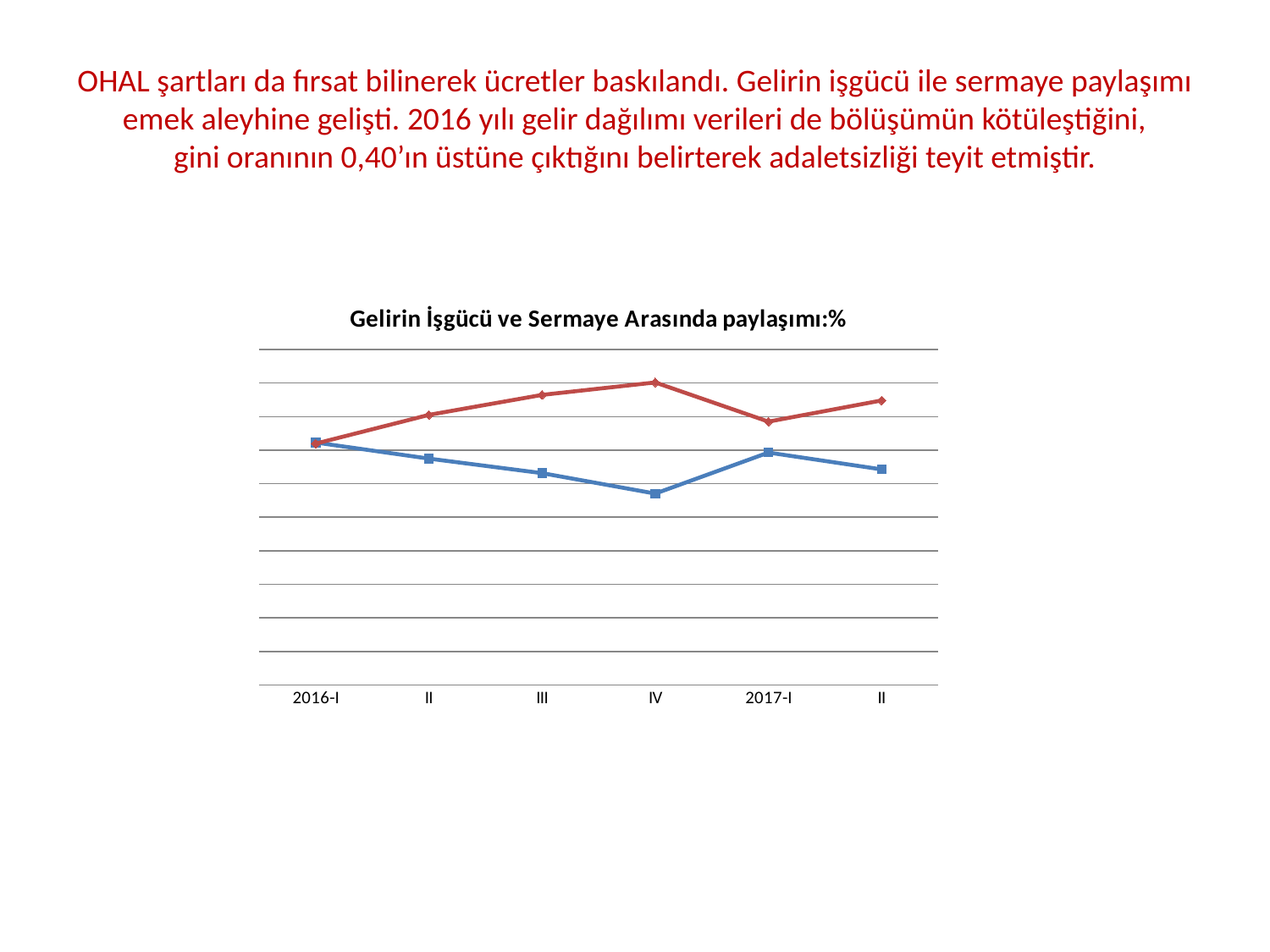
At which period is the blue line at its highest point? 2016-I How many lines are plotted on the chart? 2 Does the blue line rise or fall from 2016-I to IV? fall At 2017-I, which line is higher, the red line or the blue line? the red line What is the title of the chart? Gelirin İşgücü ve Sermaye Arasında paylaşımı:% At which period is the red line at its lowest point? 2016-I What kind of chart is shown on the slide? line chart Does the red line rise or fall from 2016-I to IV? rise At which period does the blue line reach its lowest point? IV At which period does the red line reach its highest point? IV How many periods are shown on the x axis of the chart? 6 What is the first label on the x axis of the chart? 2016-I